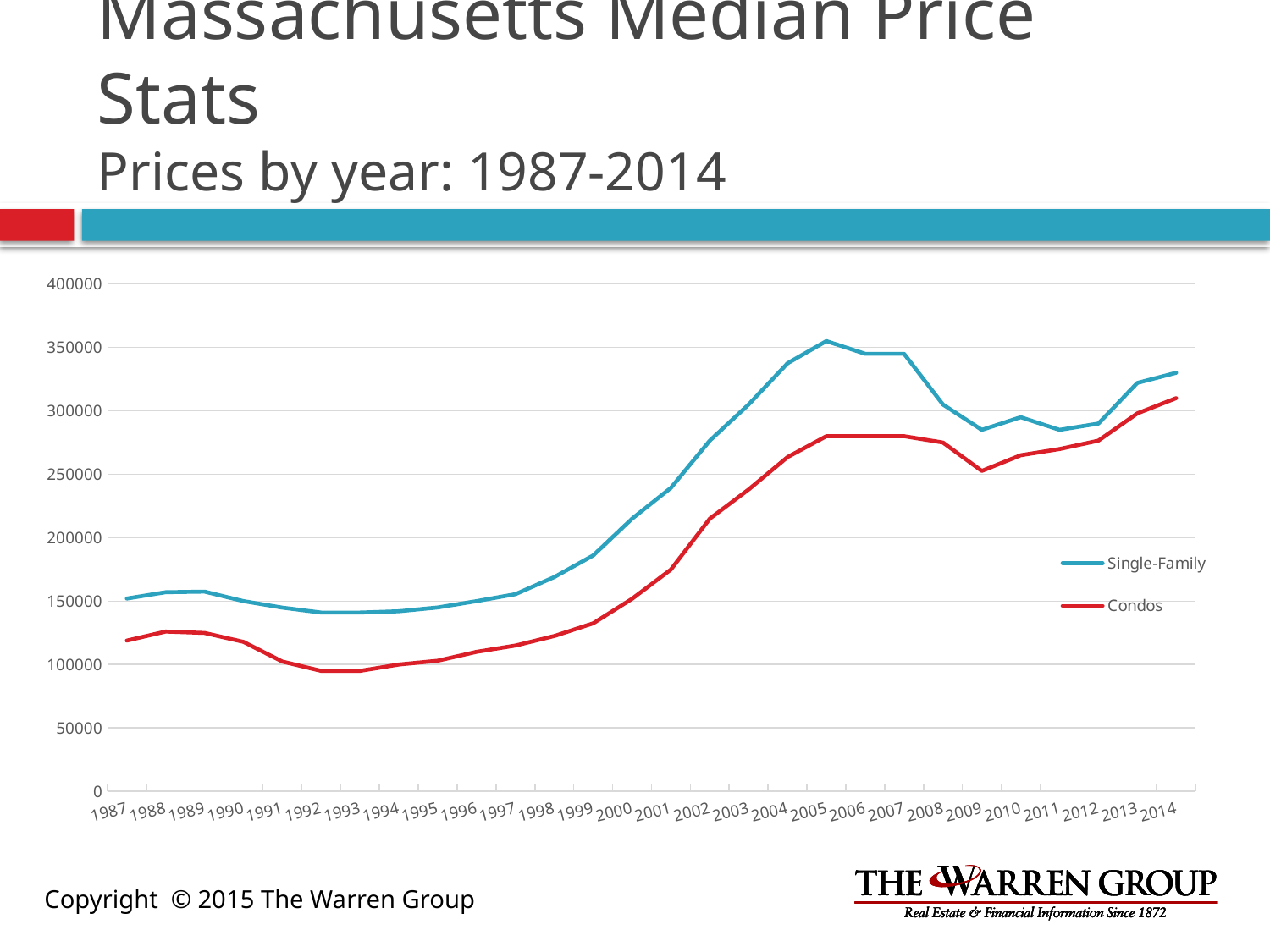
Is the Single-Family value for 2009 greater or less than 300000? less Is the Single-Family value for 2014 greater or less than 300000? greater Does the Single-Family line rise or fall between 2005 and 2009? fall In which year does the Single-Family line reach its highest value? 2005 What kind of chart is shown on the slide? line chart Does the Condos line rise or fall between 2009 and 2014? rise Is the Condos value for 1993 greater or less than 100000? less In 2005, which series has the higher value, Single-Family or Condos? Single-Family Which colour is used for the Condos line? red How many years are plotted along the x axis? 28 How many series does the legend list? 2